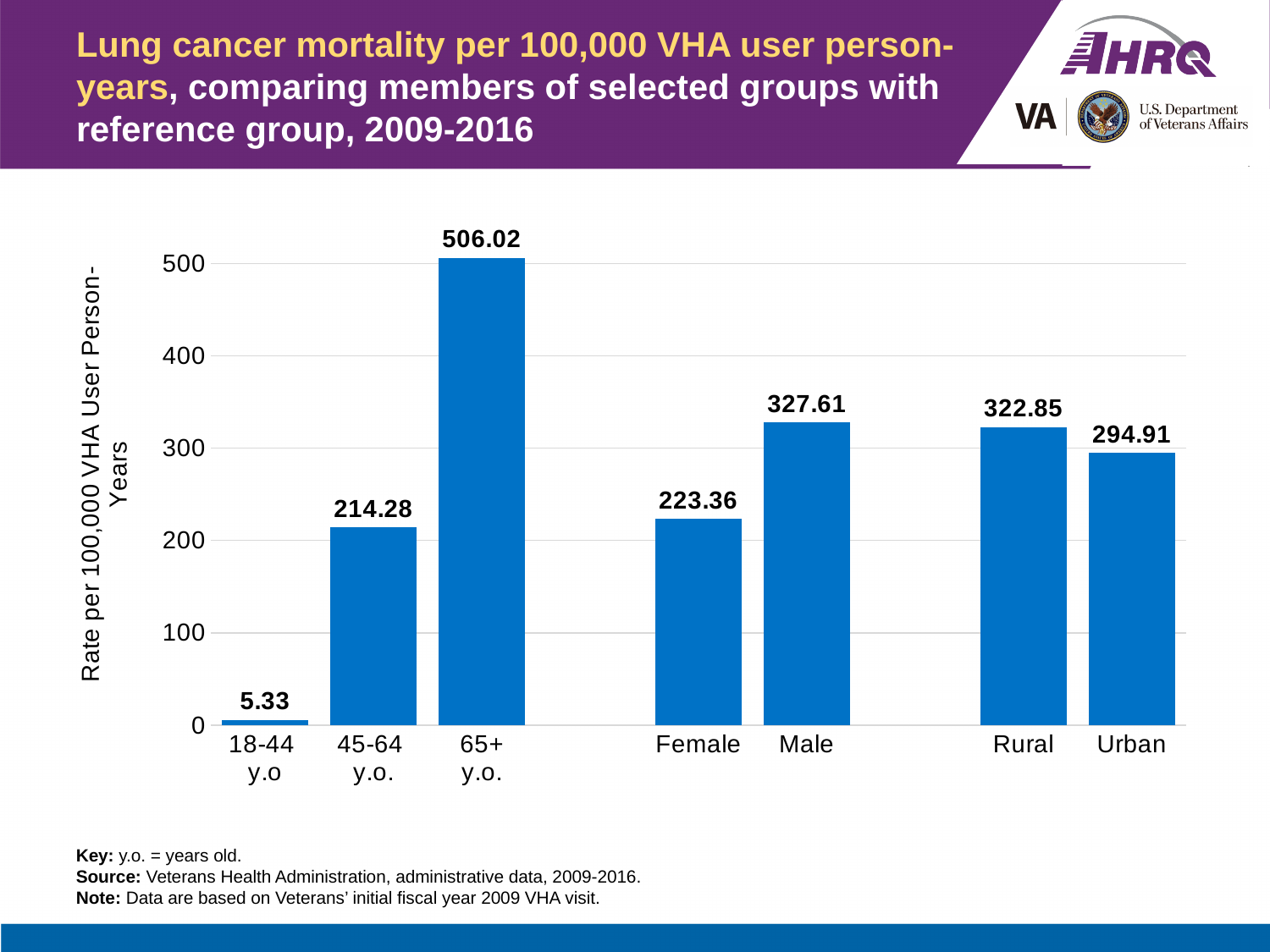
What is the value shown for the 18-44 y.o group? 5.33 Which has a higher value, Rural or Urban? Rural What is the difference between the Rural and Urban values? 27.94 Which group has the lowest lung cancer mortality rate? 18-44 y.o What is the lung cancer mortality rate for the 65+ y.o. group? 506.02 What is the difference between the Male and Female values? 104.25 What kind of chart is shown on the slide? Bar chart Is the value for the 45-64 y.o. group greater or less than 300? less How many groups (bars) are shown in the chart? 7 What is the value shown for the Urban group? 294.91 Which group has the highest lung cancer mortality rate? 65+ y.o. What is the value shown for the Female group? 223.36